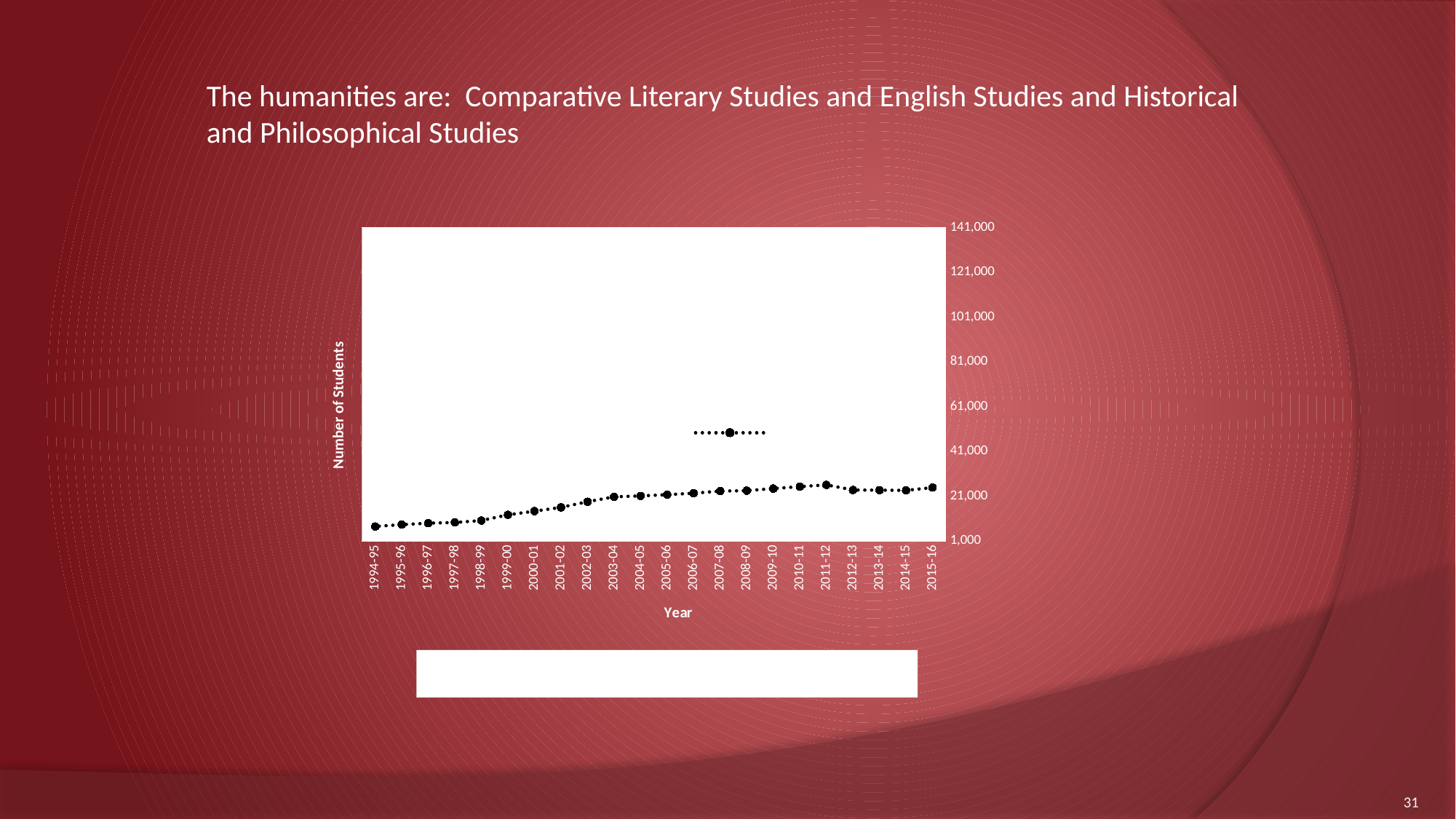
Which is larger, the number of students in 2015-16 or in 1994-95? 2015-16 Which is larger, the number of students in 2009-10 or in 1997-98? 2009-10 Is the value for 1994-95 greater or less than 21,000? less Is the value for 2000-01 greater or less than 21,000? less Which year has the lowest number of students in the chart? 1994-95 What kind of chart is shown on the slide? line chart Is the value for 2011-12 greater or less than 41,000? less Overall, does the number of students rise or fall from 1994-95 to 2015-16? rise How many years are plotted along the x axis of the chart? 22 What is the label of the x axis of the chart? Year What is the label of the y axis of the chart? Number of Students